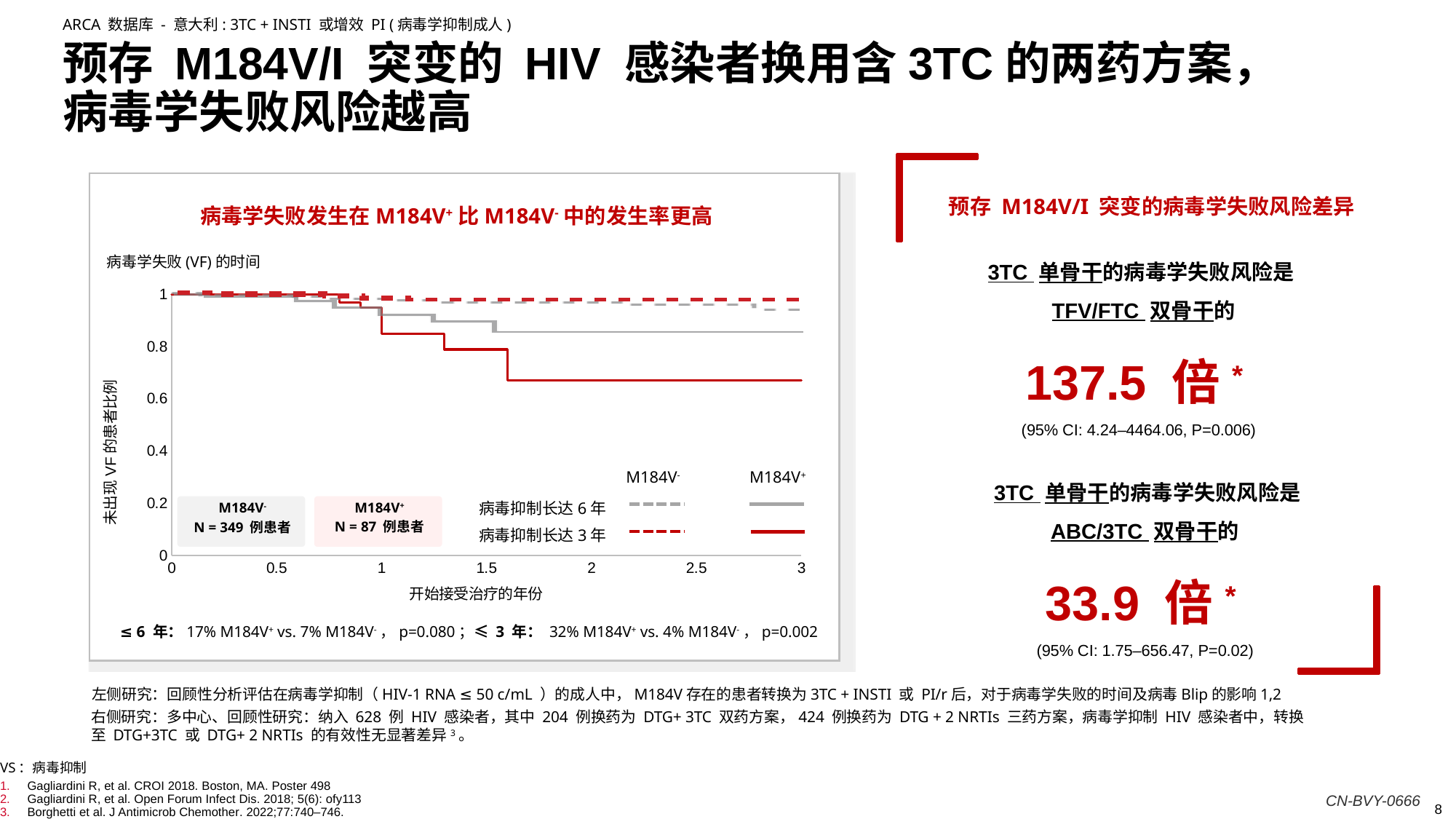
What kind of chart is shown on the left of the slide (病毒学失败 (VF) 的时间)? line chart What is the label of the y axis of the left chart? 未出现 VF 的患者比例 In the left chart, how many patients are in the M184V- group? N = 349 In the left chart, how many patients are in the M184V+ group? N = 87 In the left chart, at year 3, which curve is lower: M184V+ (病毒抑制长达 3 年) or M184V- (病毒抑制长达 3 年)? M184V+ (病毒抑制长达 3 年) According to the annotation below the left chart, what is the virological failure rate for M184V+ patients with ≤ 3 年 of viral suppression? 32% In the left chart, how many more patients are in the M184V- group than in the M184V+ group? 262 In the left chart, do the curves rise or fall as the years since starting treatment increase? fall In the left chart, how many tick marks are labelled on the x axis (开始接受治疗的年份)? 7 In the left chart, is the value of the M184V+ (病毒抑制长达 6 年) curve at year 3 greater or less than 0.8? greater In the left chart, how many line series does the legend list? 4 In the left chart, is the value of the M184V+ (病毒抑制长达 3 年) curve at year 3 greater or less than 0.8? less